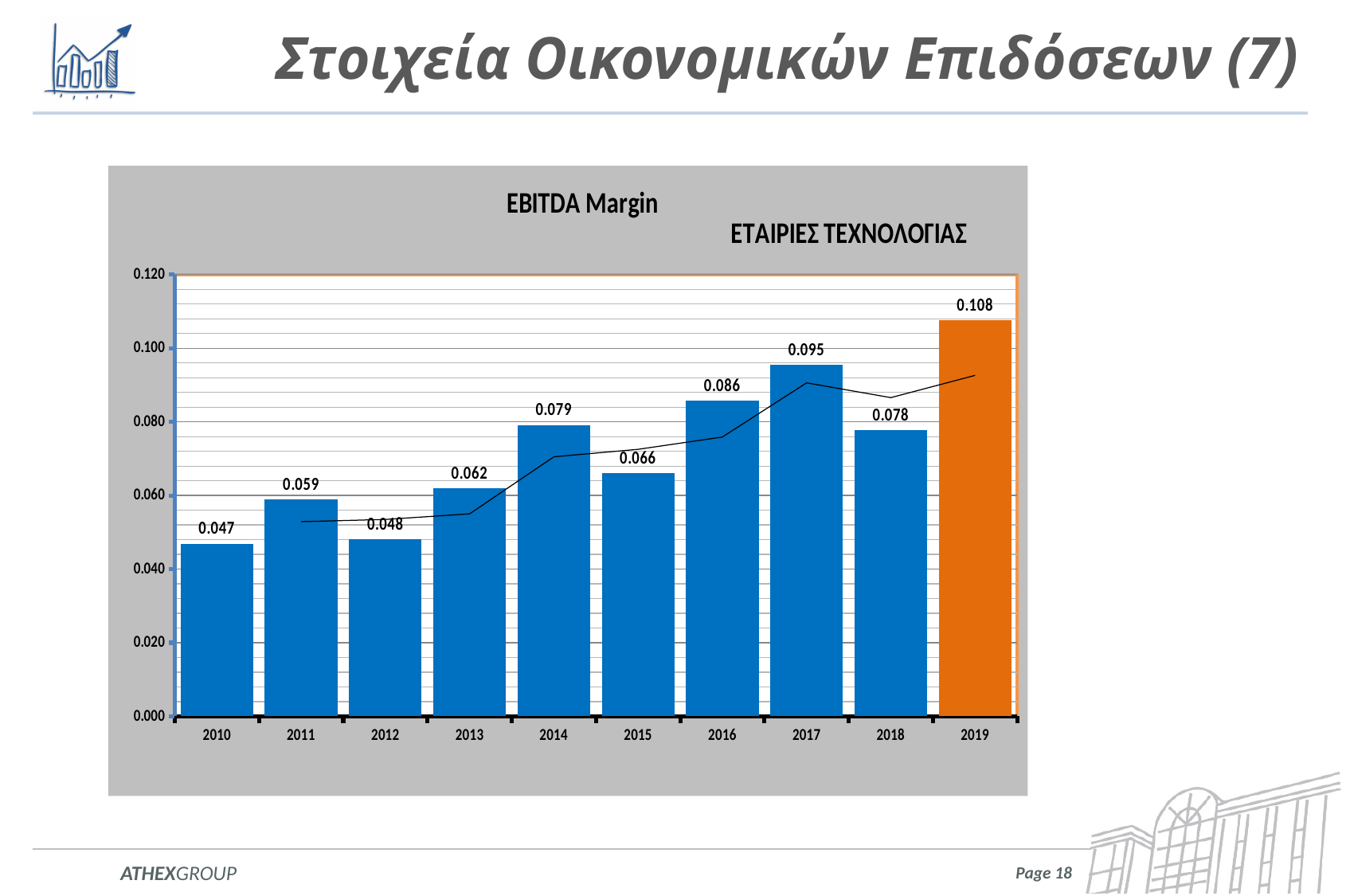
Is the EBITDA Margin value for 2016 greater or less than 0.080? greater What is the EBITDA Margin value for 2014? 0.079 How many years are shown on the x axis of the chart? 10 Which year has the lowest EBITDA Margin? 2010 What is the EBITDA Margin value for 2010? 0.047 What is the difference between the EBITDA Margin in 2019 and in 2018? 0.030 What is the EBITDA Margin value for 2019? 0.108 Which year has a higher EBITDA Margin, 2017 or 2018? 2017 Which year's bar is coloured orange instead of blue? 2019 Which year has the highest EBITDA Margin? 2019 Does the EBITDA Margin rise or fall from 2017 to 2018? Fall What kind of chart is used to show the EBITDA Margin? Bar chart